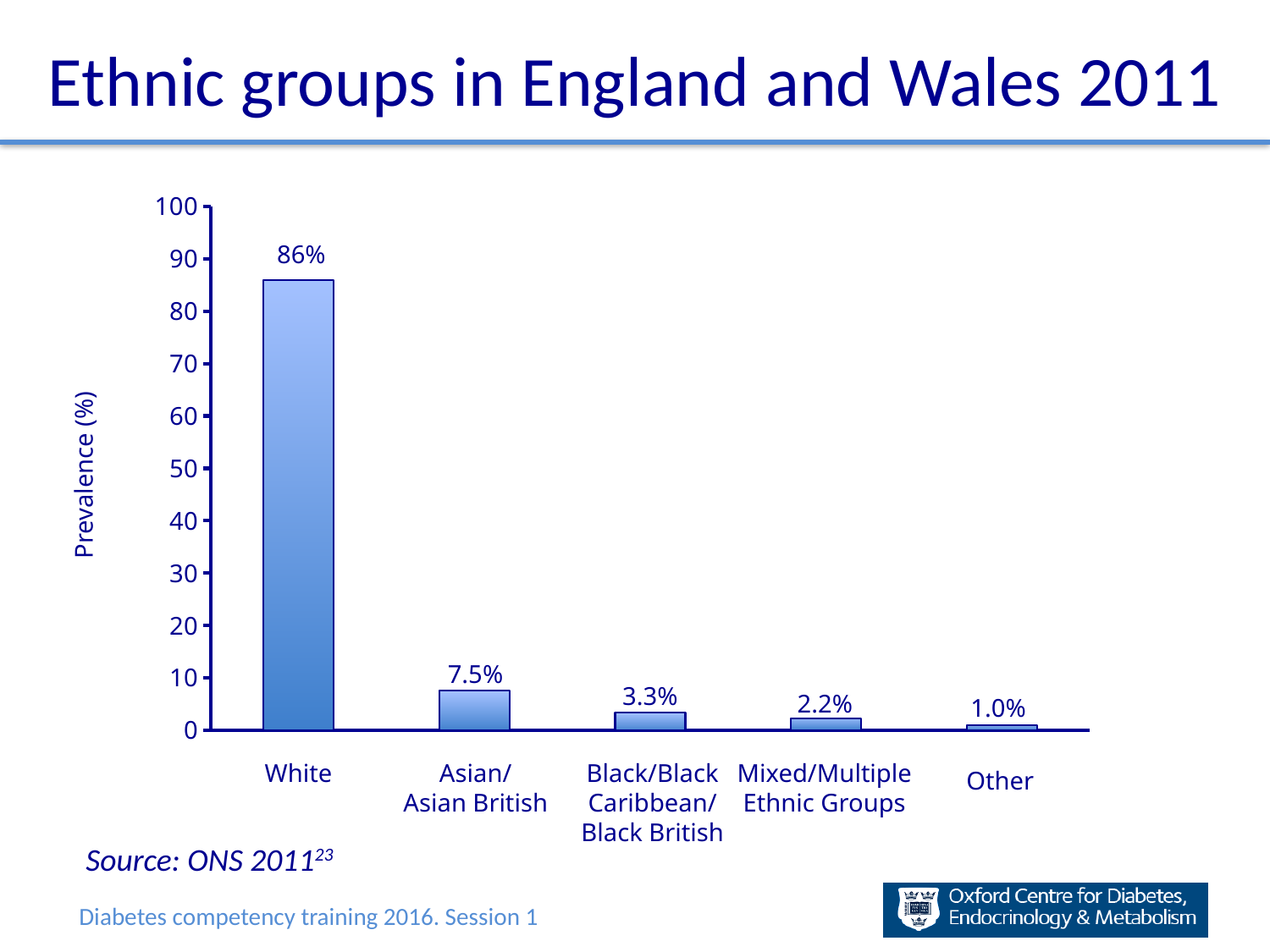
Which has a larger prevalence, Mixed/Multiple Ethnic Groups or Other? Mixed/Multiple Ethnic Groups Which ethnic group has the highest prevalence? White How many ethnic groups are shown on the chart? 5 What kind of chart is shown on the slide? Bar chart What is the prevalence for Mixed/Multiple Ethnic Groups? 2.2% What is the prevalence for Black/Black Caribbean/Black British? 3.3% What is the label of the y axis? Prevalence (%) Which ethnic group has the lowest prevalence? Other What is the prevalence for Asian/Asian British? 7.5% What is the difference in prevalence between Asian/Asian British and Black/Black Caribbean/Black British? 4.2% What is the prevalence for the White ethnic group? 86% What is the prevalence for the Other category? 1.0%